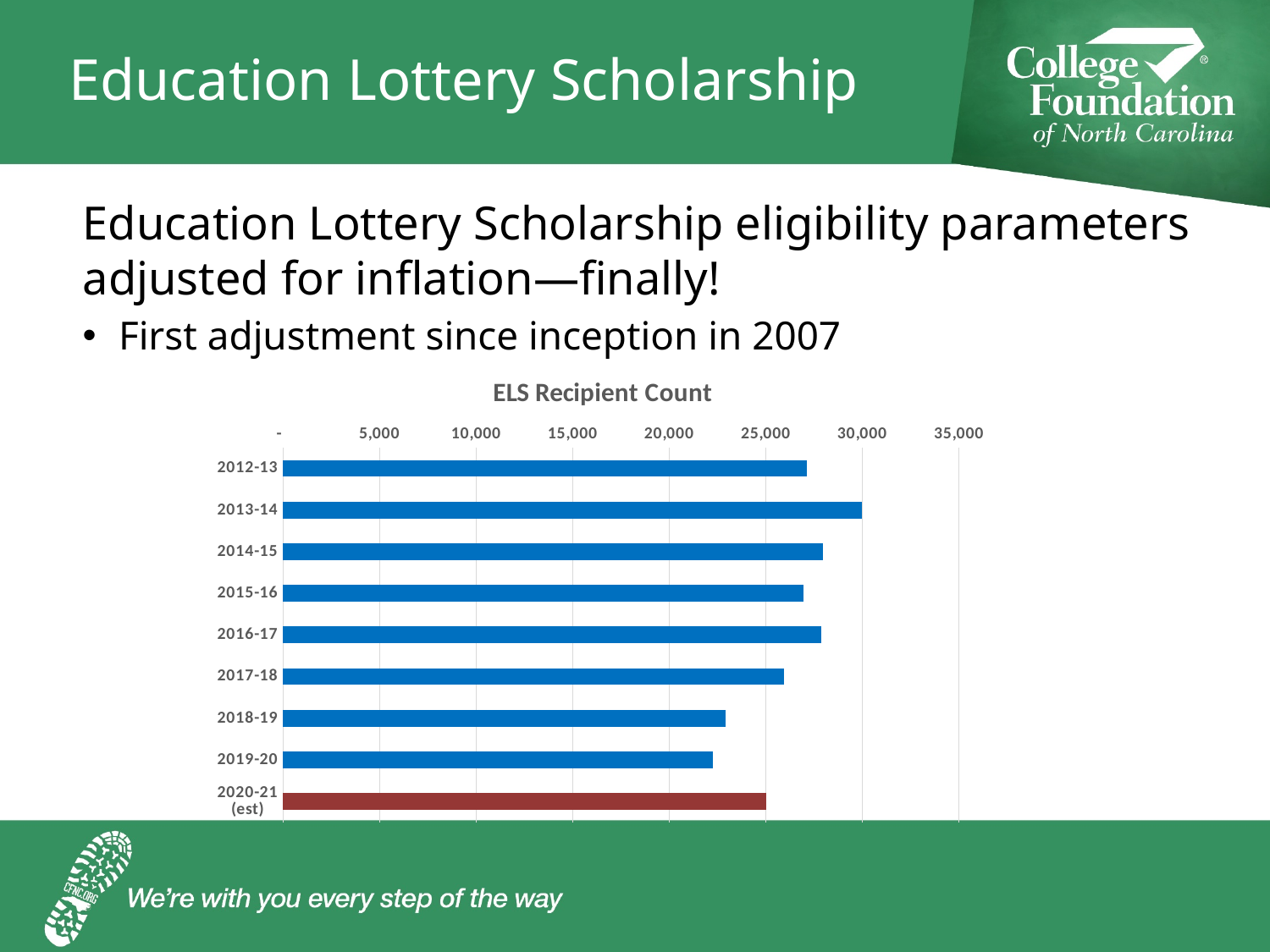
Which academic year has the highest ELS recipient count? 2013-14 How many academic years are shown in the chart? 9 Which bar is shown in a different colour (red) from the others? 2020-21 (est) Which has a higher ELS recipient count, 2013-14 or 2019-20? 2013-14 What is the title of the chart? ELS Recipient Count Is the value for 2018-19 greater or less than 25,000? less Which has a higher ELS recipient count, 2014-15 or 2018-19? 2014-15 Is the value for 2013-14 greater or less than 25,000? greater Is the value for 2012-13 greater or less than 20,000? greater Which academic year has the lowest ELS recipient count? 2019-20 What type of chart is shown on the slide? Bar chart